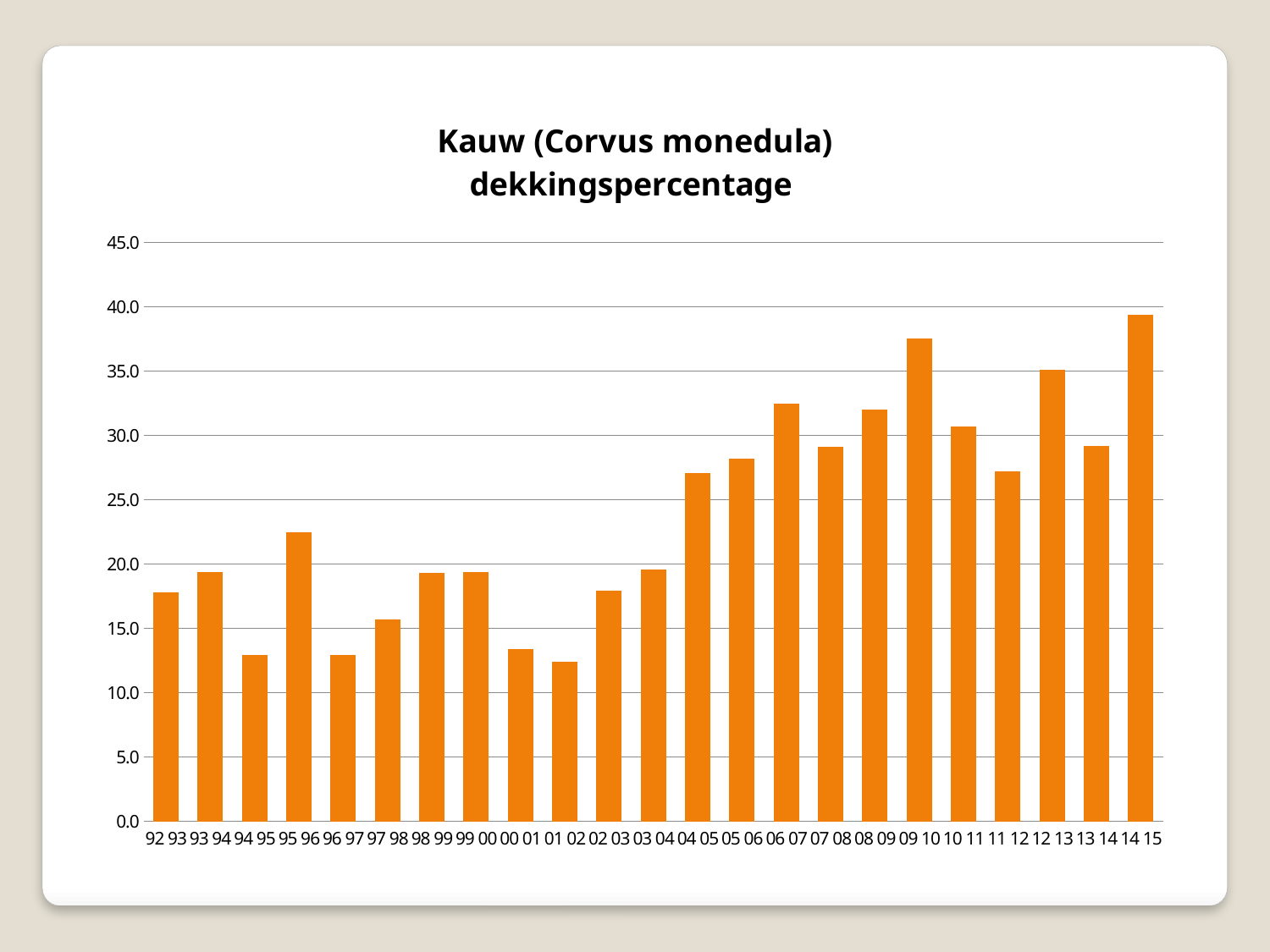
Is the value for 95 96 greater or less than 20.0? greater What is the title of the chart? Kauw (Corvus monedula) dekkingspercentage Which is larger, the value for 09 10 or the value for 12 13? 09 10 Is the value for 92 93 greater or less than 20.0? less Overall, do the values rise or fall from 92 93 to 14 15? rise Which season has the highest dekkingspercentage? 14 15 How many bars (seasons) are plotted in the chart? 23 Is the value for 06 07 greater or less than 30.0? greater Which is larger, the value for 95 96 or the value for 94 95? 95 96 What kind of chart is shown on the slide? bar chart